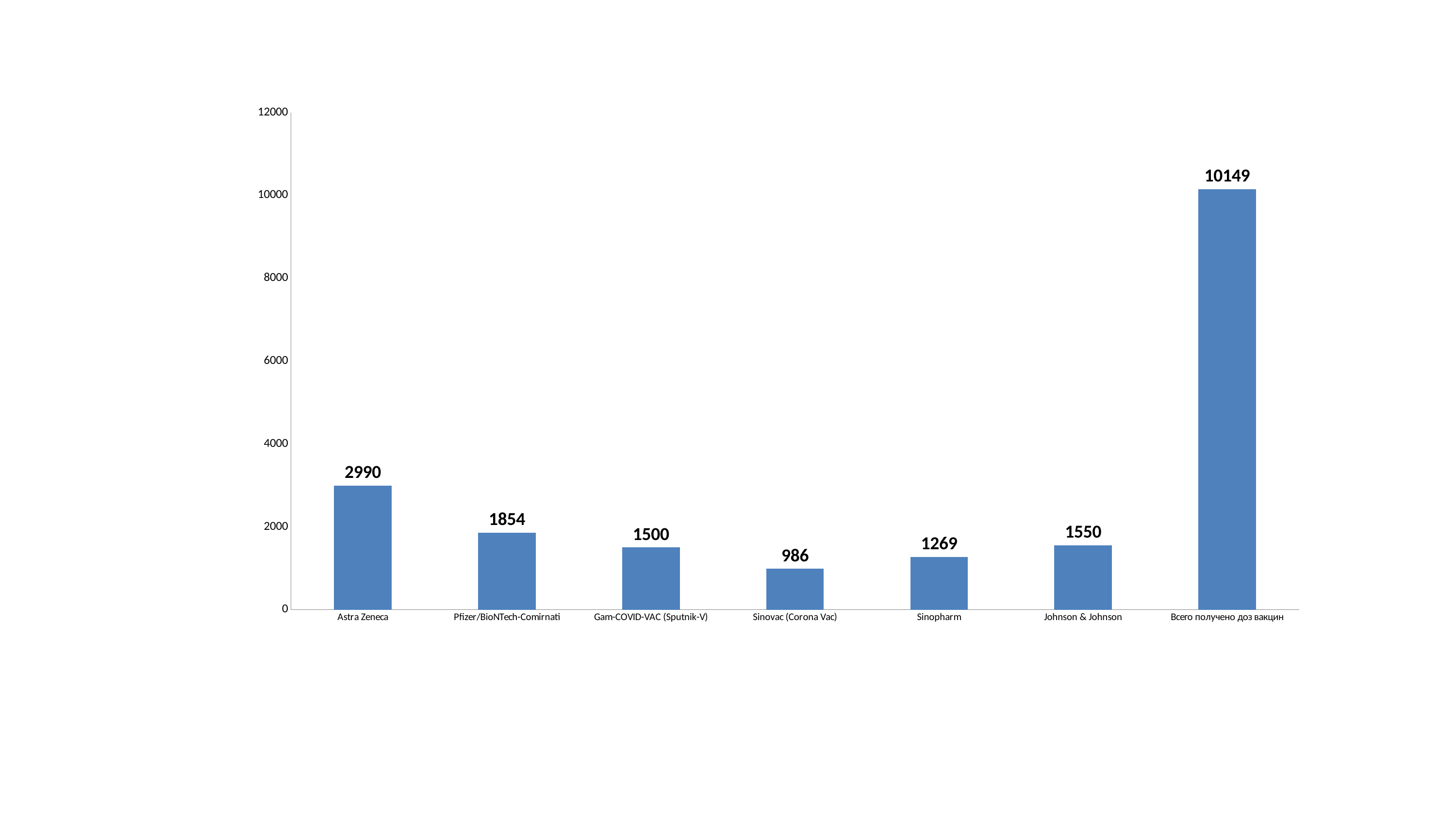
What is the value for Pfizer/BioNTech-Comirnati? 1854 Which category has the highest value? Всего получено доз вакцин What is the value for Astra Zeneca? 2990 What is the value for Sinovac (Corona Vac)? 986 Which is larger, the value for Sinopharm or the value for Johnson & Johnson? Johnson & Johnson Which category has the lowest value? Sinovac (Corona Vac) What is the difference between the values for Astra Zeneca and Gam-COVID-VAC (Sputnik-V)? 1490 Is the value for Gam-COVID-VAC (Sputnik-V) greater or less than 2000? less What is the value for Всего получено доз вакцин? 10149 What kind of chart is shown on the slide? bar chart How many categories are shown on the x axis? 7 What is the value for Johnson & Johnson? 1550